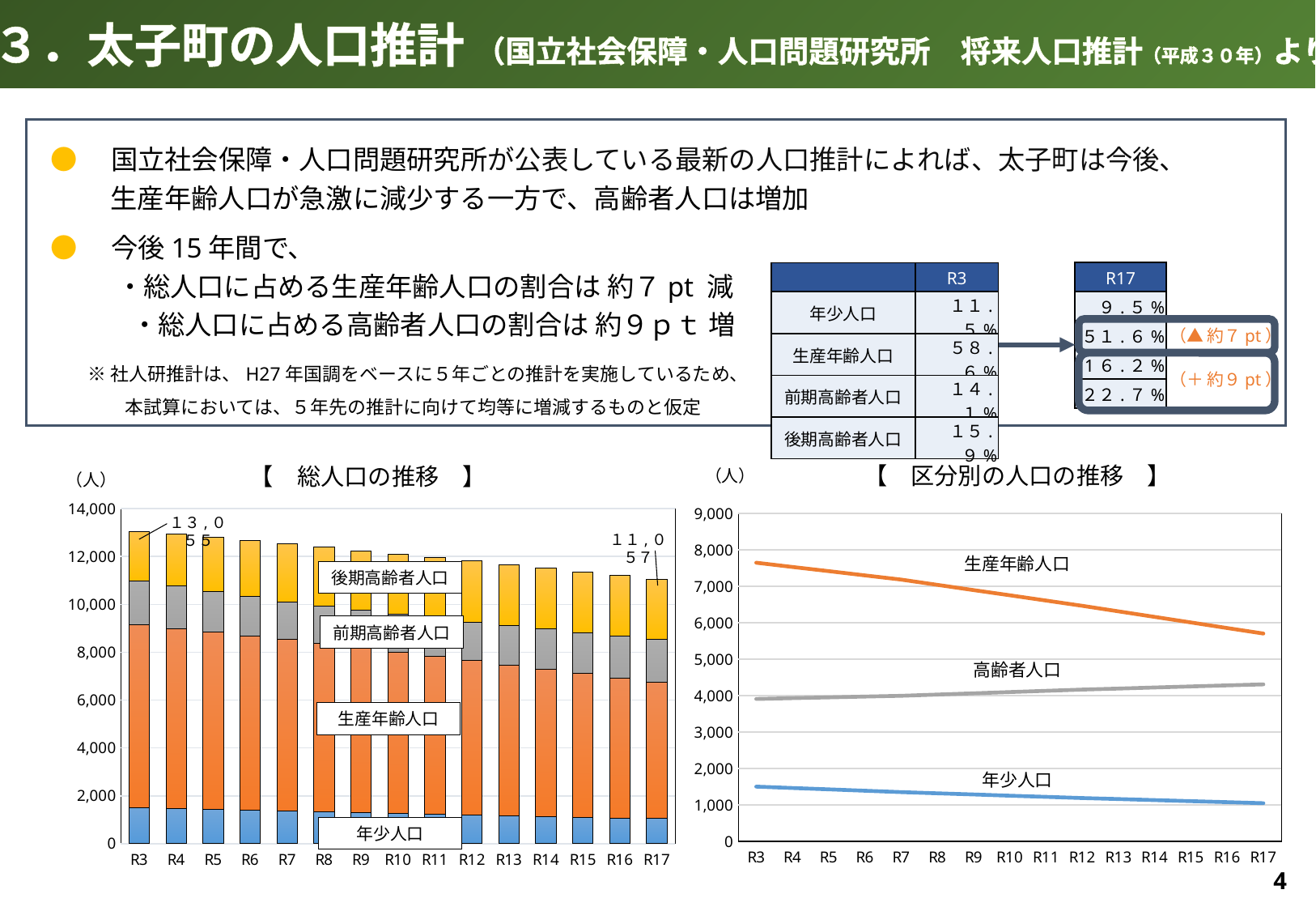
In the left chart (総人口の推移), does the total population rise or fall from R3 to R17? fall In the left chart (総人口の推移), how many years (categories) are shown on the x axis? 15 In the right chart (区分別の人口の推移), is the value of 生産年齢人口 at R17 greater or less than 6,000? less In the left chart (総人口の推移), what is the total population shown for R3? 13,055 What kind of chart is the left chart titled 総人口の推移? stacked bar chart In the right chart (区分別の人口の推移), how many series (lines) are plotted? 3 What kind of chart is the right chart titled 区分別の人口の推移? line chart In the left chart (総人口の推移), is the total for R17 greater or less than 12,000? less In the right chart (区分別の人口の推移), does 高齢者人口 rise or fall from R3 to R17? rise In the left chart (総人口の推移), what is the difference between the R3 total and the R17 total? 1,998 In the left chart (総人口の推移), what is the total population shown for R17? 11,057 In the right chart (区分別の人口の推移), which series has the highest values? 生産年齢人口